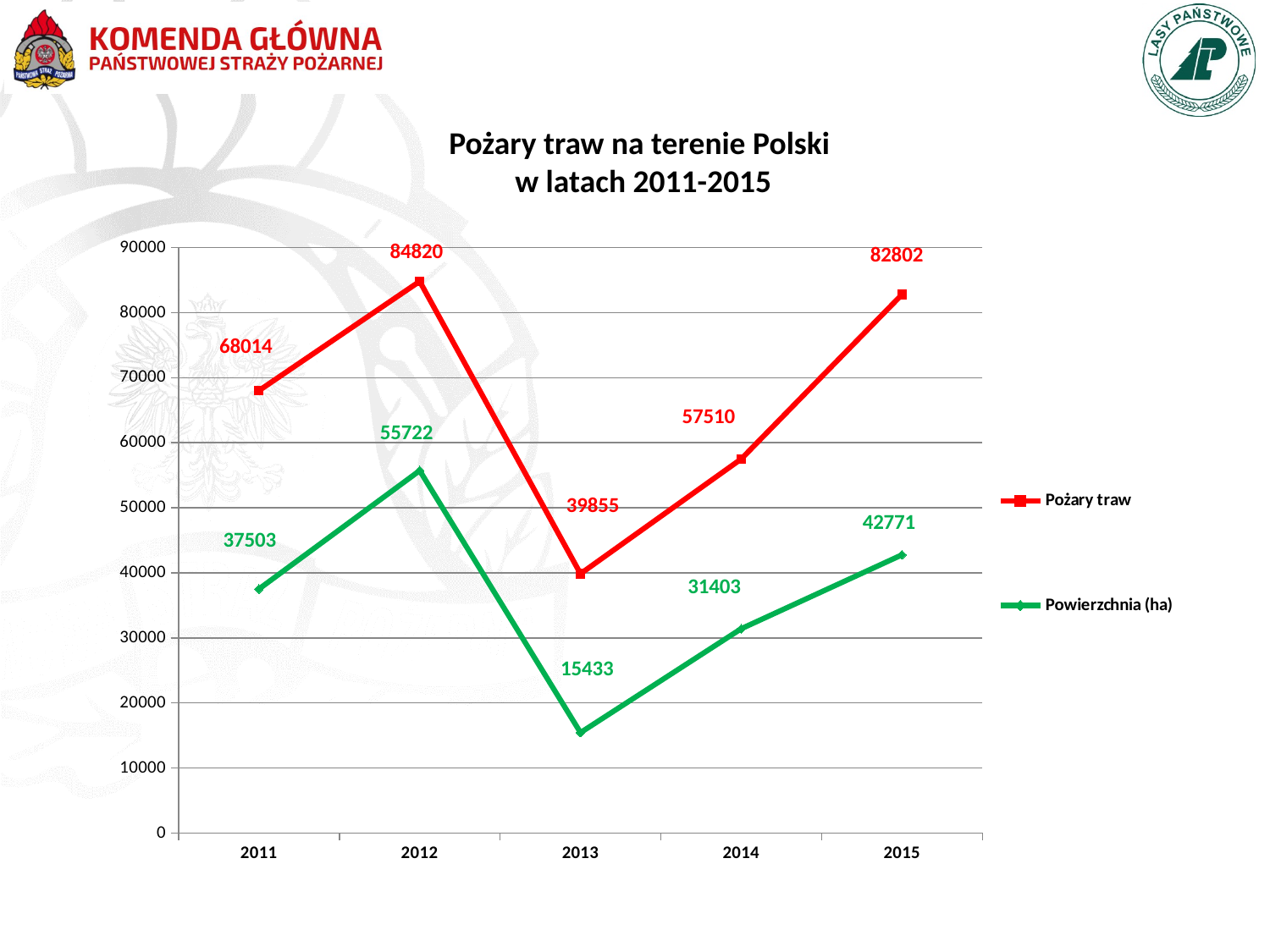
What is the value of Pożary traw in 2015? 82802 Is the value for Pożary traw in 2014 greater or less than 60000? less What is the difference between Pożary traw in 2012 and 2013? 44965 Which is larger: Powierzchnia (ha) in 2012 or in 2015? 2012 How many series does the legend list? 2 How many years are shown on the x axis? 5 What is the value of Powierzchnia (ha) in 2013? 15433 What is the value of Pożary traw in 2012? 84820 Does Powierzchnia (ha) rise or fall from 2013 to 2015? rise In which year is Powierzchnia (ha) lowest? 2013 What kind of chart is shown? line chart In which year is Pożary traw highest? 2012